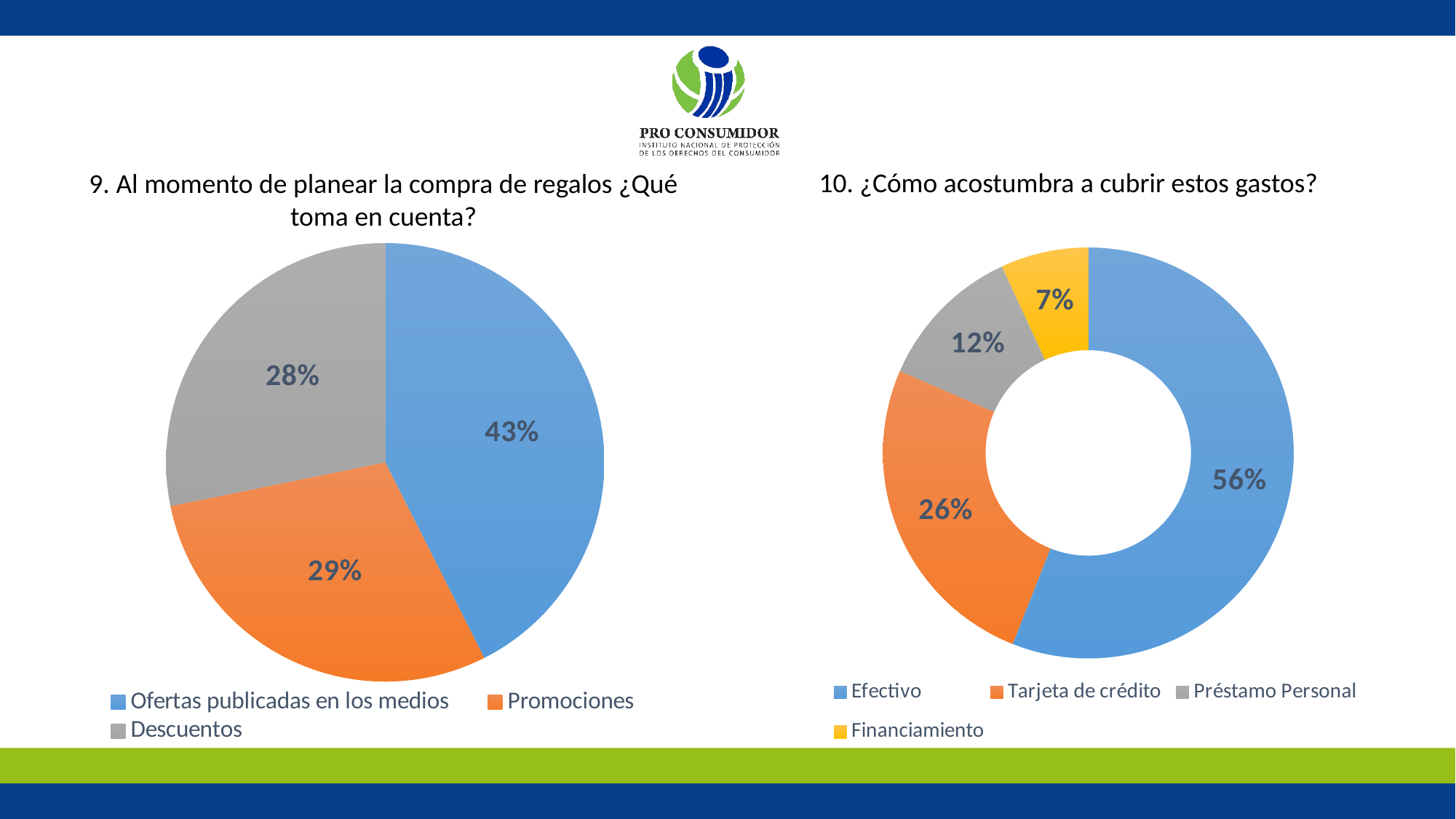
In the left chart (question 9), how many categories does the legend list? 3 What type of chart is shown on the right side of the slide (question 10)? Doughnut chart In the left chart (question 9), what share is labelled for Ofertas publicadas en los medios? 43% In the right chart (question 10), which is larger: Tarjeta de crédito or Préstamo Personal? Tarjeta de crédito In the right chart (question 10), what share is labelled for Financiamiento? 7% In the left chart (question 9), which category has the largest slice? Ofertas publicadas en los medios In the right chart (question 10), what share is labelled for Efectivo? 56% In the right chart (question 10), what is the difference in percentage points between Efectivo and Tarjeta de crédito? 30 percentage points In the left chart (question 9), what share is labelled for Descuentos? 28% In the right chart (question 10), how many categories does the legend list? 4 In the left chart (question 9), what is the difference in percentage points between Promociones and Descuentos? 1 percentage point In the right chart (question 10), which category has the smallest slice? Financiamiento